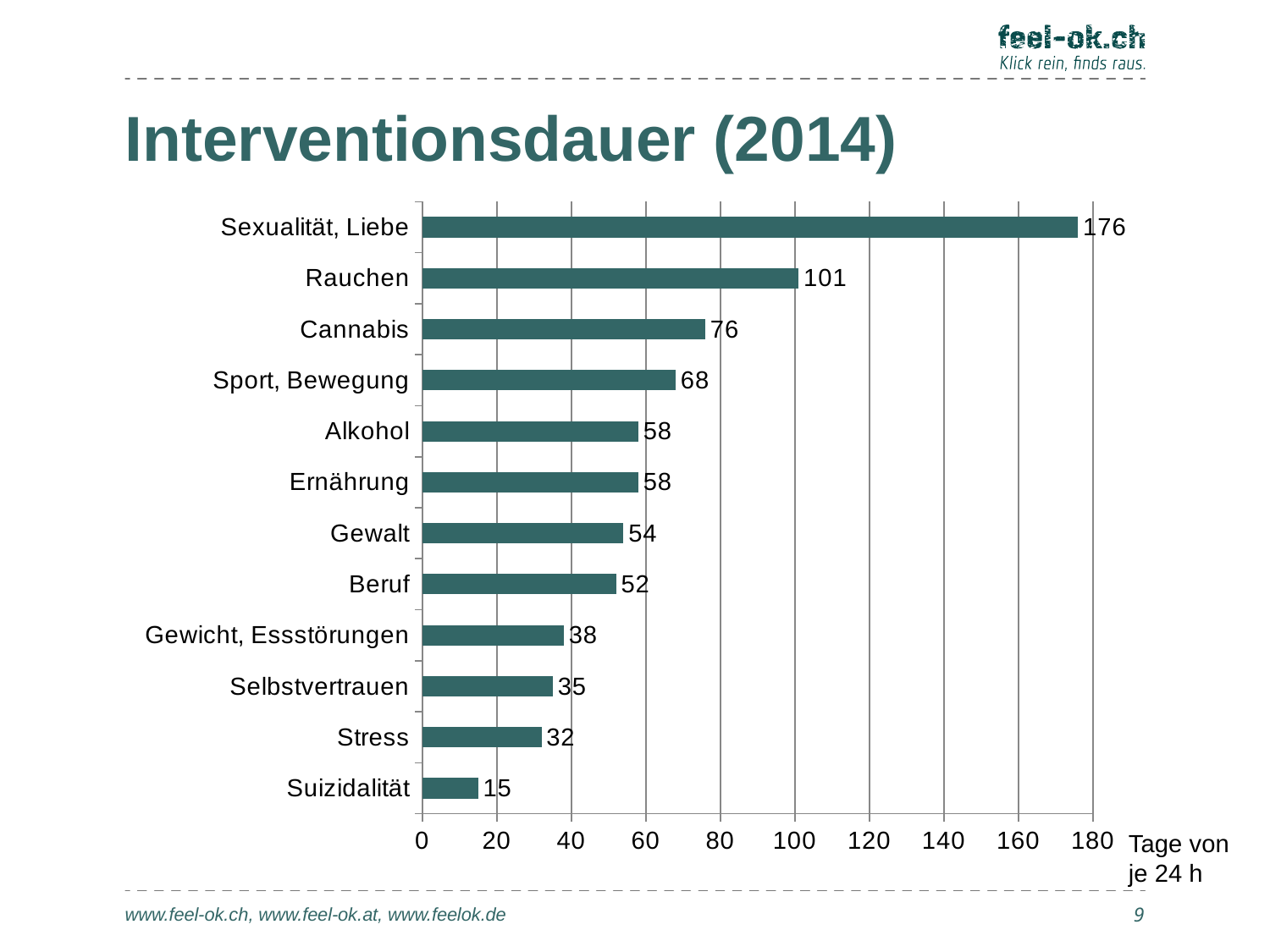
Which category has the lowest value? Suizidalität What is the value for Suizidalität? 15 How many categories are shown in the chart? 12 Is the value for Stress greater or less than 40? less What is the value for Rauchen? 101 What is the title of the chart? Interventionsdauer (2014) What is the difference between the values for Cannabis and Sport, Bewegung? 8 What is the difference between the values for Sexualität, Liebe and Rauchen? 75 Which is larger, the value for Gewalt or the value for Beruf? Gewalt What is the value for Gewicht, Essstörungen? 38 Which category has the highest value? Sexualität, Liebe What kind of chart is shown on the slide? bar chart